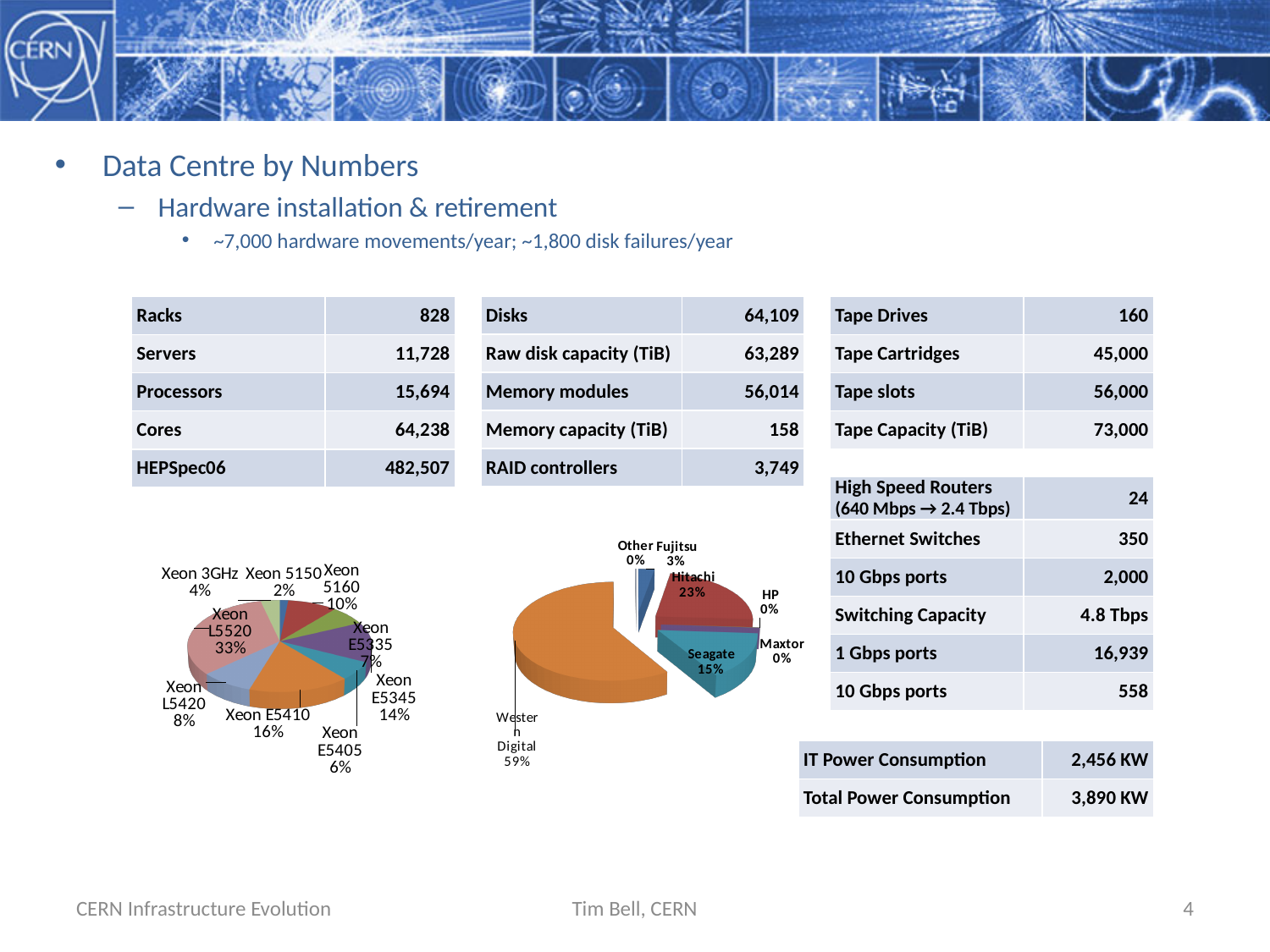
What kind of chart is the right chart on the slide? Pie chart In the left pie chart, which processor type has the smallest share? Xeon 5150 How many processor types are shown in the left pie chart? 9 In the left pie chart, what share does Xeon L5520 have? 33% In the right pie chart, what share does Hitachi have? 23% In the left pie chart, what is the difference between the shares of Xeon E5345 and Xeon E5335? 7% In the right pie chart, what share does Western Digital have? 59% In the left pie chart, what share does Xeon E5410 have? 16% In the right pie chart, which manufacturer has the largest share? Western Digital In the right pie chart, what is the difference between the shares of Hitachi and Seagate? 8% In the left pie chart, which has a larger share, Xeon 5160 or Xeon L5420? Xeon 5160 In the left pie chart, which processor type has the largest share? Xeon L5520